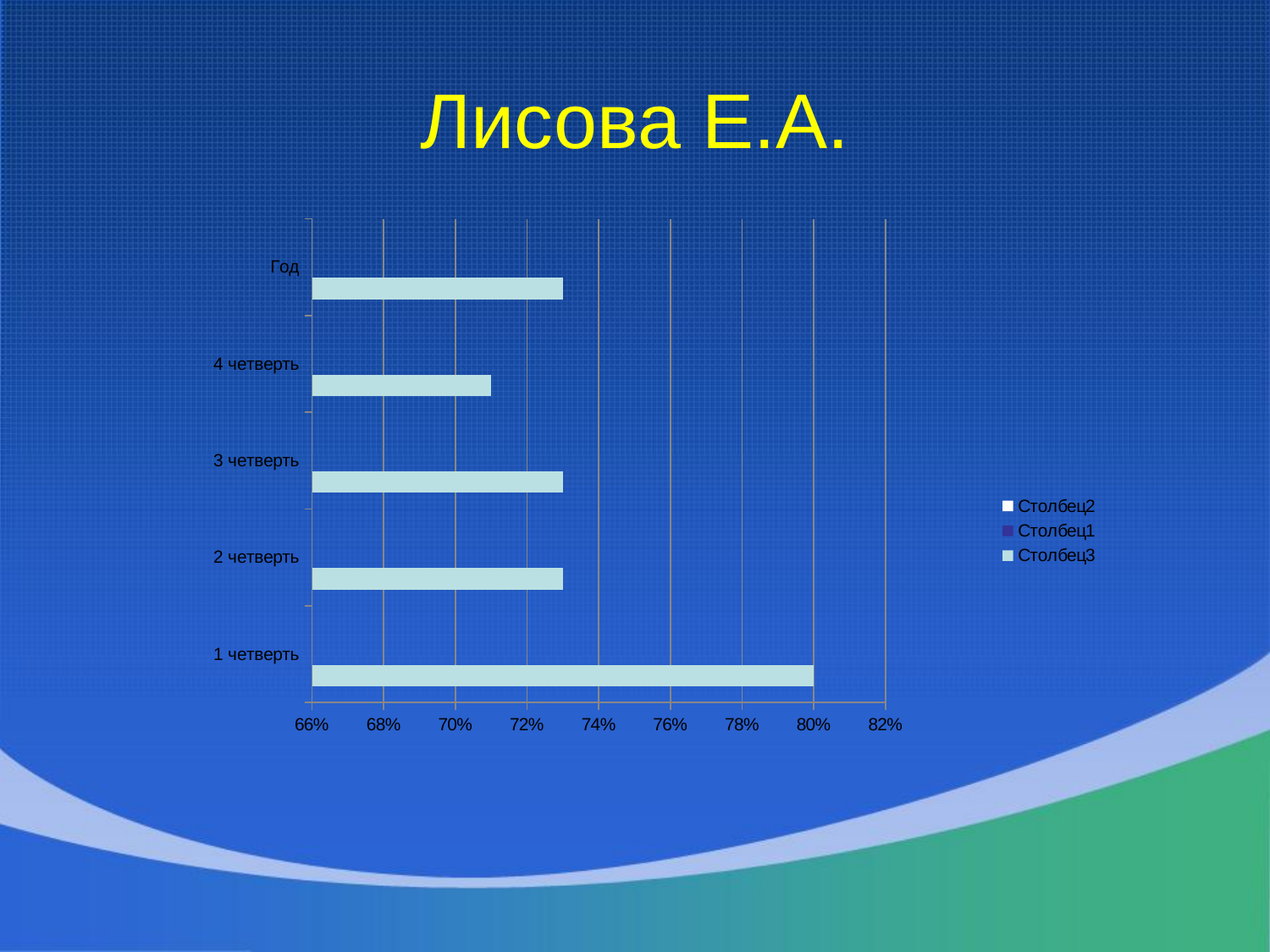
Which category has the lowest value? 4 четверть Is the value for 2 четверть greater or less than 74%? less What is the value for 1 четверть? 80% What is the title of the slide above the chart? Лисова Е.А. How many categories are plotted on the chart? 5 What kind of chart is shown on the slide? bar chart How many series does the legend list? 3 Which is larger, the value for 1 четверть or the value for 4 четверть? 1 четверть Is the value for Год greater or less than 72%? greater Which category has the highest value? 1 четверть Is the value for 4 четверть greater or less than 72%? less What are the entries listed in the chart legend? Столбец2, Столбец1, Столбец3